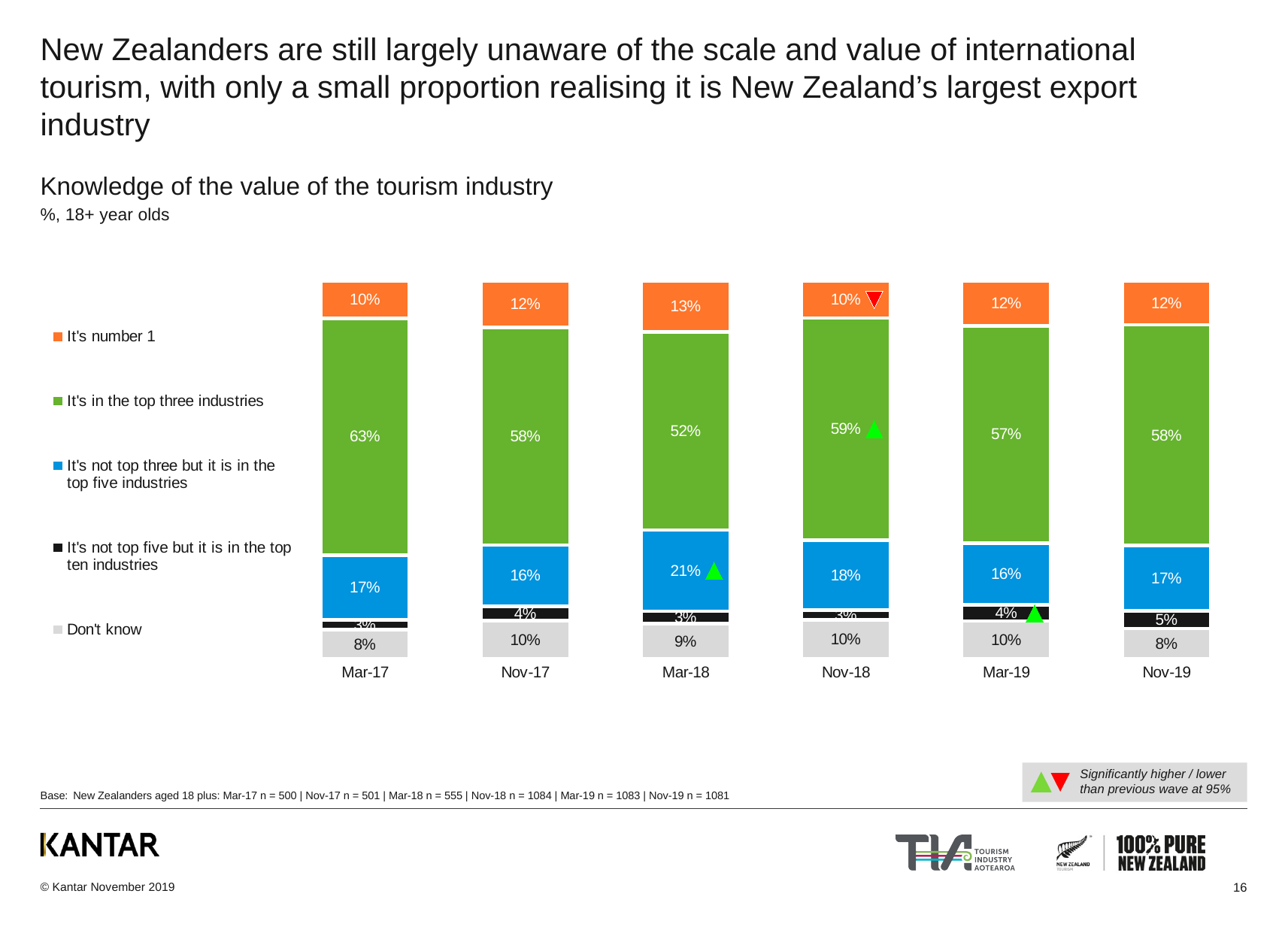
What percentage said 'It's not top three but it is in the top five industries' in Mar-18? 21% How many series does the legend list? 5 In which wave was the 'It's in the top three industries' share highest? Mar-17 Which series is shown in orange in the legend? It's number 1 Which is larger: the 'It's number 1' share in Nov-17 or in Nov-18? Nov-17 What is the difference between the 'It's in the top three industries' share in Mar-17 and Mar-18? 11 percentage points How many survey waves (categories) are shown along the x axis? 6 What percentage said 'It's in the top three industries' in Mar-17? 63% What percentage answered 'Don't know' in Nov-19? 8% In which wave was the 'It's in the top three industries' share lowest? Mar-18 What kind of chart is shown on the slide? Stacked bar chart What percentage said 'It's number 1' in Mar-18? 13%